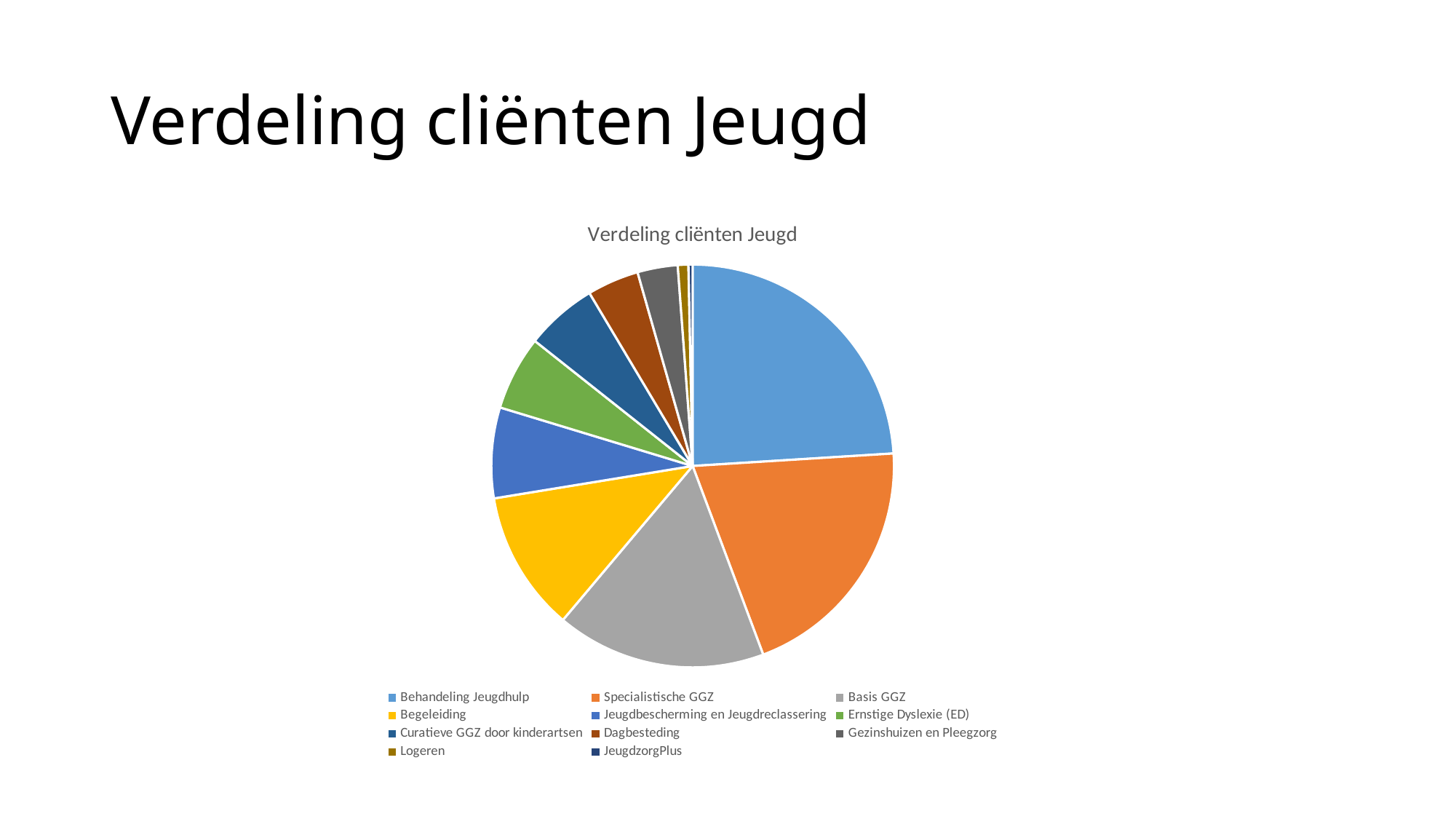
What kind of chart is shown on the slide? pie chart Which category has the largest slice of the pie? Behandeling Jeugdhulp Which slice is larger, Ernstige Dyslexie (ED) or Dagbesteding? Ernstige Dyslexie (ED) What is the title of the chart? Verdeling cliënten Jeugd How many categories does the legend of the pie chart list? 11 Which slice is larger, Specialistische GGZ or Begeleiding? Specialistische GGZ Which slice is larger, Basis GGZ or Curatieve GGZ door kinderartsen? Basis GGZ Which category is shown in yellow in the pie chart? Begeleiding